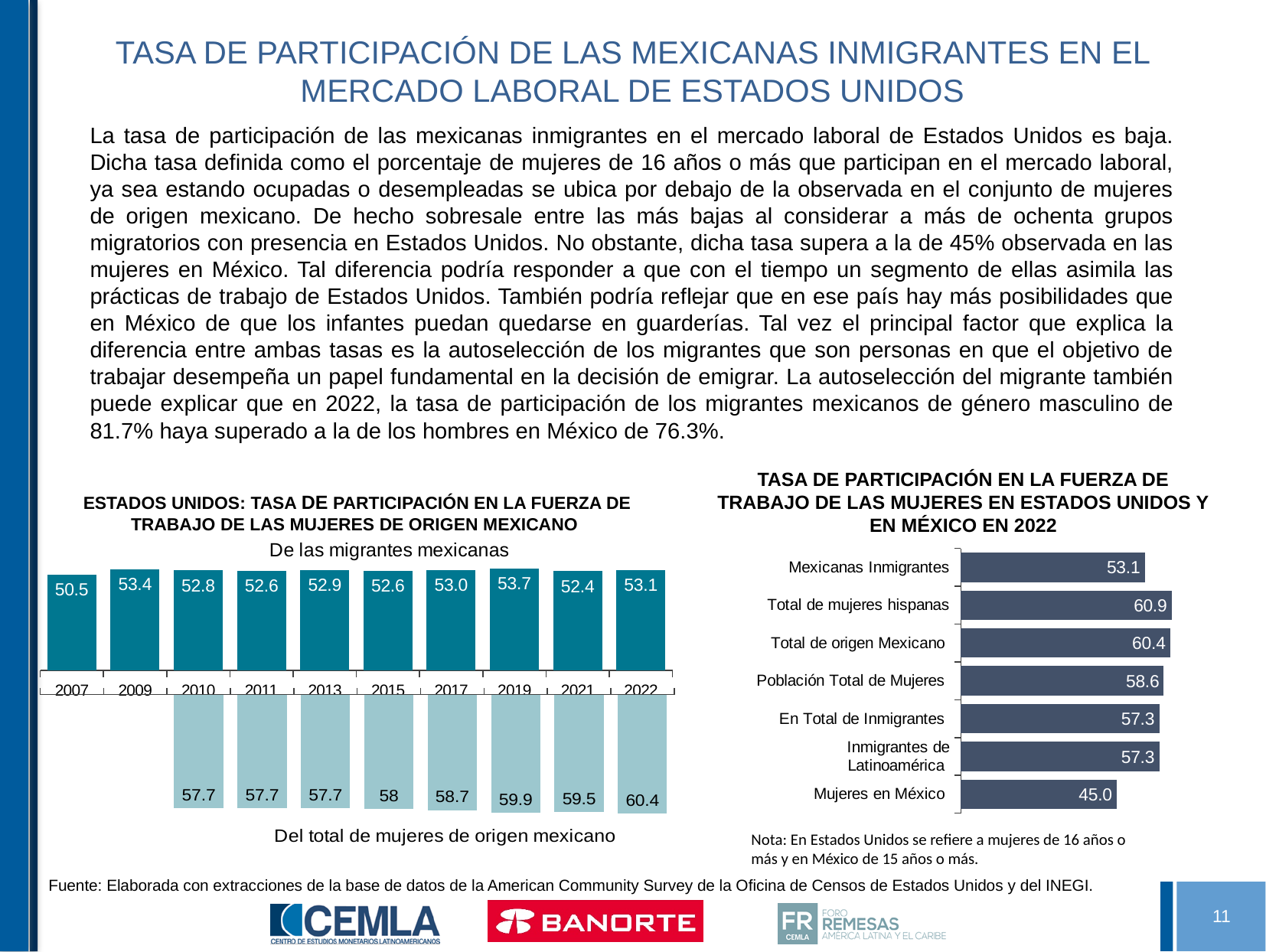
In the left chart, which year has the highest value for 'De las migrantes mexicanas'? 2019 In the right chart, what is the difference between 'Mexicanas Inmigrantes' and 'Mujeres en México'? 8.1 In the right chart, which category has the lowest value? Mujeres en México In the left chart, what is the difference between 'Del total de mujeres de origen mexicano' and 'De las migrantes mexicanas' in 2022? 7.3 In the right chart (Tasa de participación en la fuerza de trabajo de las mujeres en Estados Unidos y en México en 2022), what is the value for 'Mujeres en México'? 45.0 In the right chart, how many categories are shown? 7 In the left chart (Estados Unidos: tasa de participación en la fuerza de trabajo de las mujeres de origen mexicano), what is the value for 'De las migrantes mexicanas' in 2007? 50.5 In the left chart, what is the value for 'Del total de mujeres de origen mexicano' in 2022? 60.4 In the right chart, which category has the highest value? Total de mujeres hispanas In the left chart, which year has the lowest value for 'De las migrantes mexicanas'? 2007 In the left chart, how many years are shown on the x axis? 10 In the left chart, what kind of chart is used? Bar chart